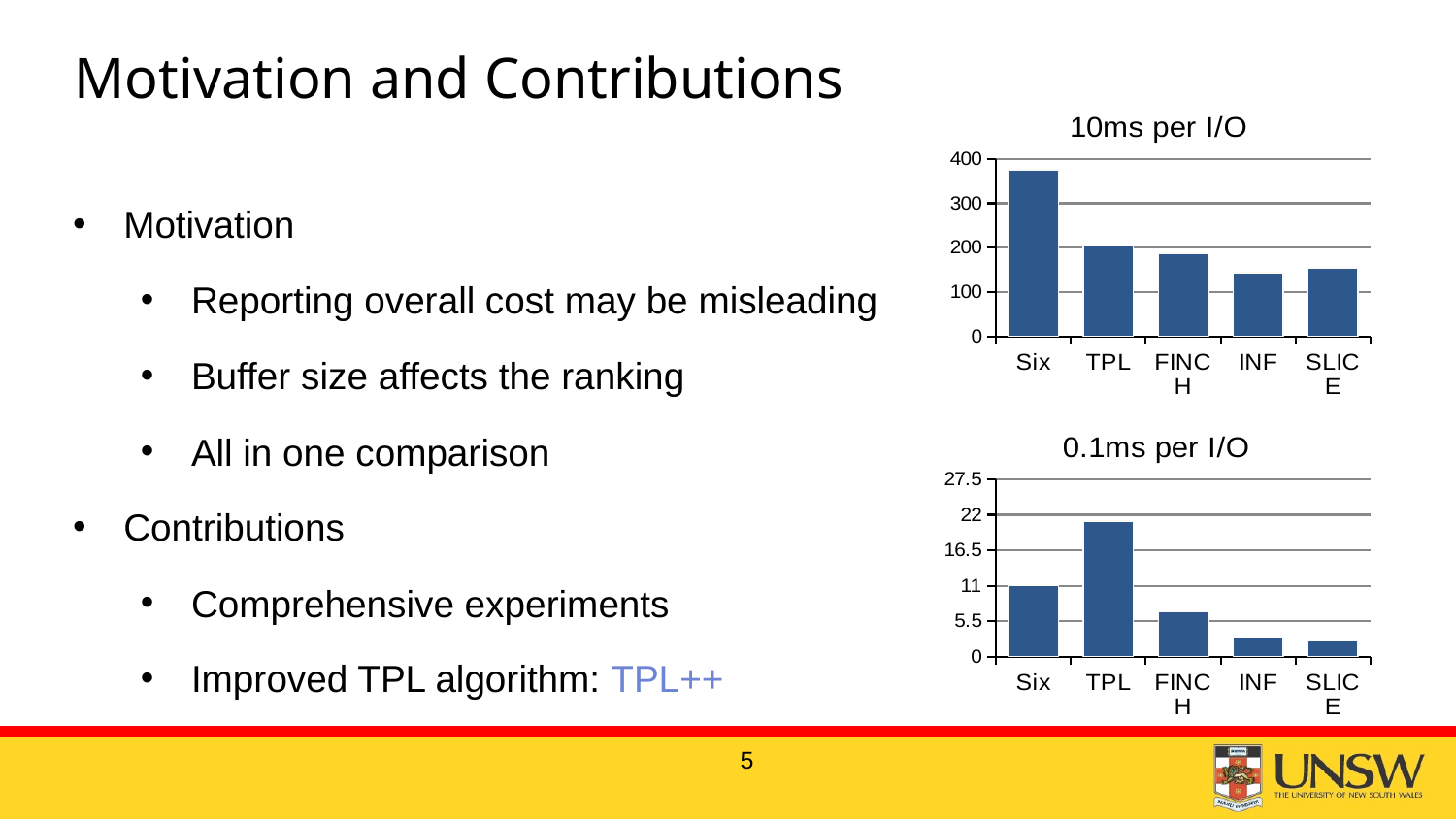
In the chart titled "0.1ms per I/O", is the value for FINCH greater or less than 5.5? greater In the chart titled "0.1ms per I/O", which category has the highest value? TPL In the chart titled "0.1ms per I/O", which is larger, the value for Six or the value for TPL? TPL In the chart titled "10ms per I/O", is the value for Six greater or less than 300? greater In the chart titled "10ms per I/O", is the value for INF greater or less than 200? less What kind of chart is the chart titled "0.1ms per I/O"? bar chart In the chart titled "10ms per I/O", which is larger, the value for Six or the value for TPL? Six What is the title of the upper chart on the slide? 10ms per I/O In the chart titled "10ms per I/O", which category has the highest value? Six How many categories are shown on the x axis of the chart titled "10ms per I/O"? 5